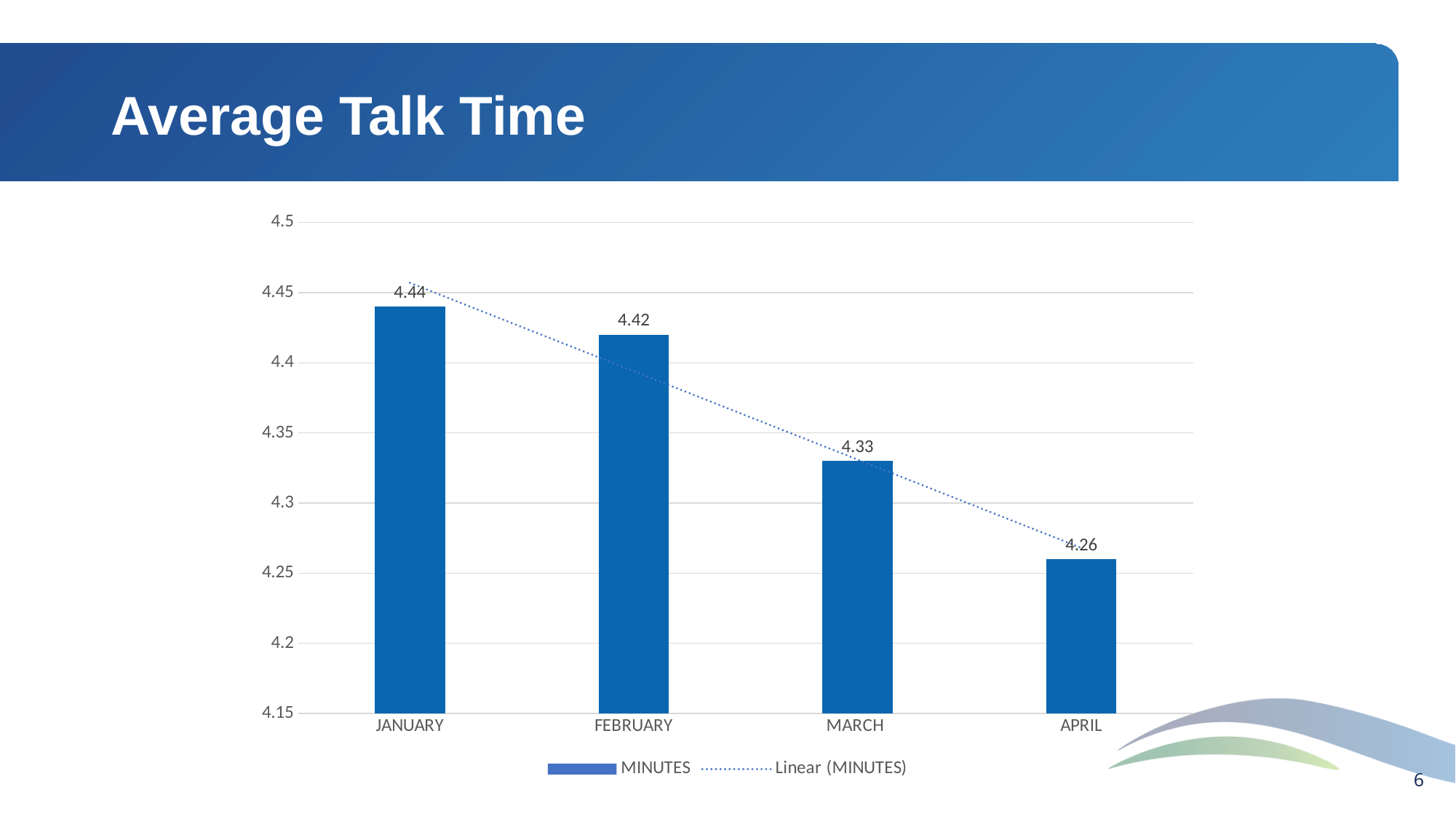
Do the average talk time values rise or fall from January to April? Fall What is the average talk time in minutes for March? 4.33 What is the difference in average talk time between January and April? 0.18 What kind of chart is shown on the slide? Bar chart Which month has a higher average talk time, February or March? February How many months are shown on the chart? 4 What is the difference in average talk time between February and March? 0.09 What is the average talk time in minutes for April? 4.26 Is the value for April greater or less than 4.3? less What is the average talk time in minutes for January? 4.44 Which month has the highest average talk time? January Which month has the lowest average talk time? April